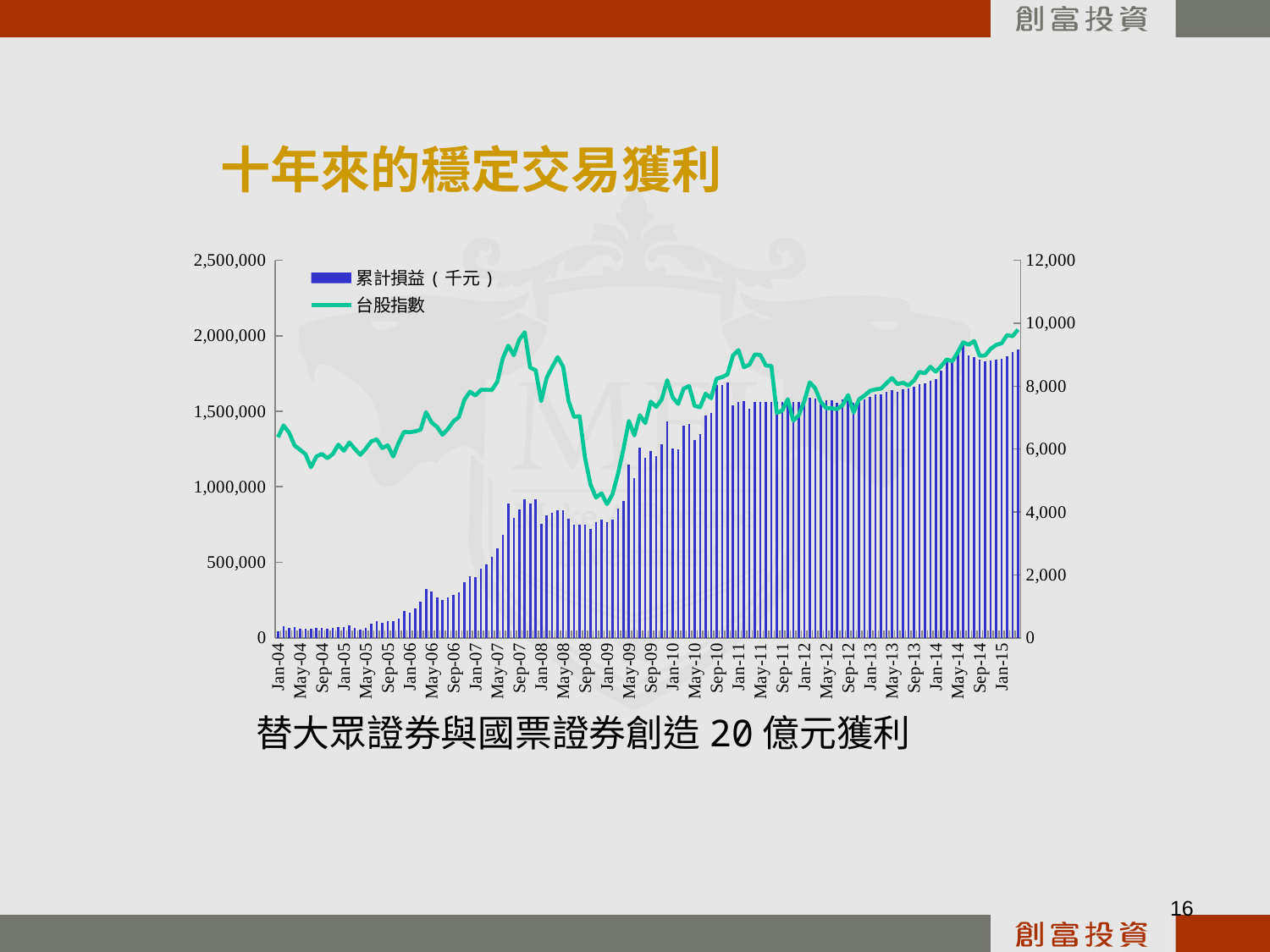
What is the title shown above the chart? 十年來的穩定交易獲利 Is the 台股指數 value for Jan-09 greater or less than 6,000? less How many series does the chart legend list? 2 What are the two series named in the legend? 累計損益（千元） and 台股指數 What kind of chart is used to plot 台股指數? Line chart Is the 累計損益（千元） value for Jan-04 greater or less than 500,000? less What kind of chart is used to plot 累計損益（千元）? Bar chart Does the 累計損益（千元） series generally rise or fall from Jan-04 to Jan-15? rise Is the 台股指數 value for Jan-15 greater or less than 8,000? greater Does the 台股指數 line rise or fall from Sep-07 to Jan-09? fall